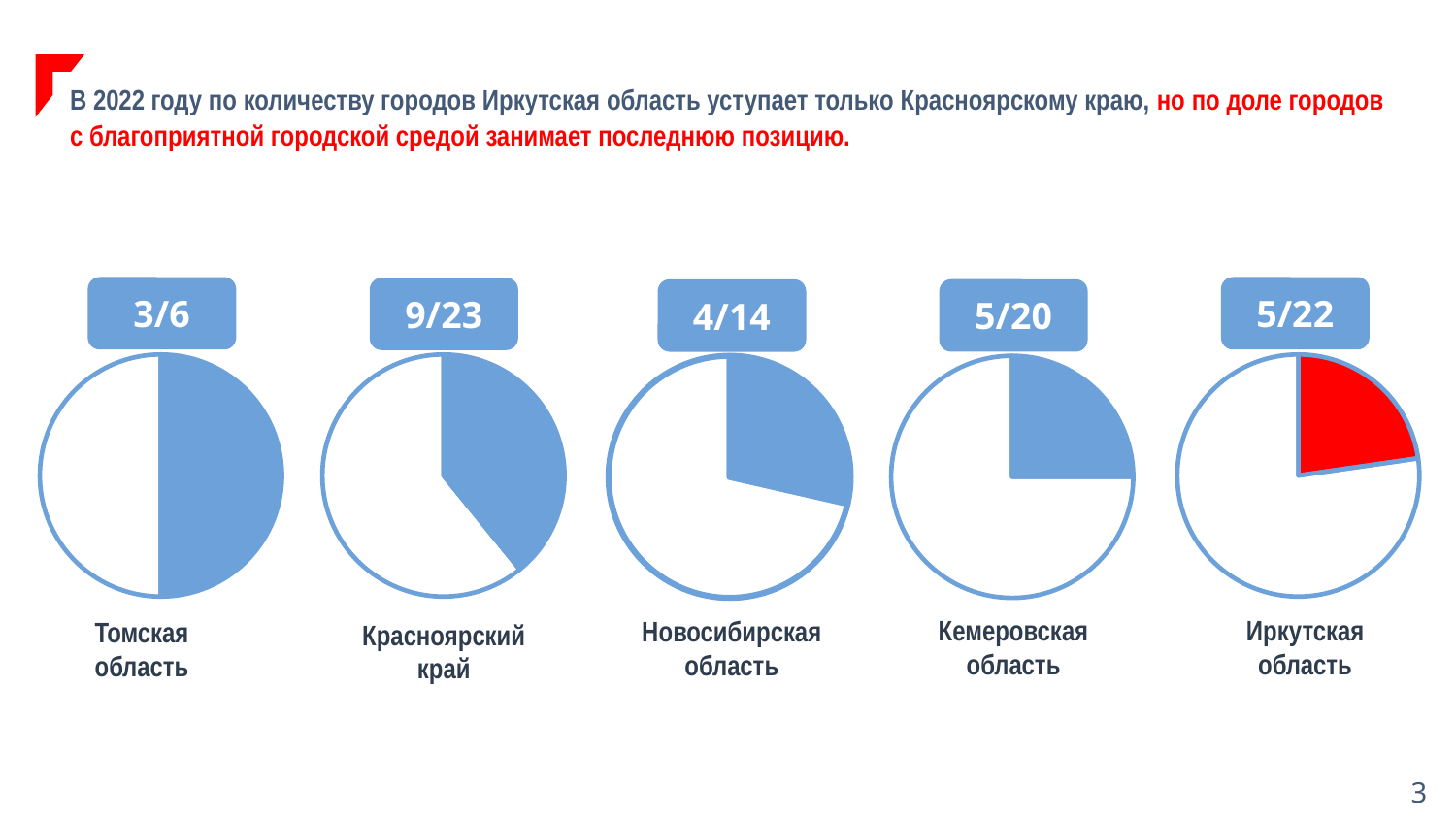
Which region's pie chart shows the smallest filled share? Иркутская область How many pie charts are shown on the slide? 5 Which region has the largest total number of cities according to the labels above the pie charts? Красноярский край What value is printed above the pie chart for Томская область? 3/6 Which region has the larger filled share of its pie: Красноярский край or Новосибирская область? Красноярский край What colour is the filled slice in the pie chart for Иркутская область? Red What value is printed above the pie chart for Иркутская область? 5/22 What value is printed above the pie chart for Красноярский край? 9/23 What value is printed above the pie chart for Кемеровская область? 5/20 What value is printed above the pie chart for Новосибирская область? 4/14 What kind of charts are shown on the slide? Pie charts Which region's pie chart shows the largest filled share? Томская область